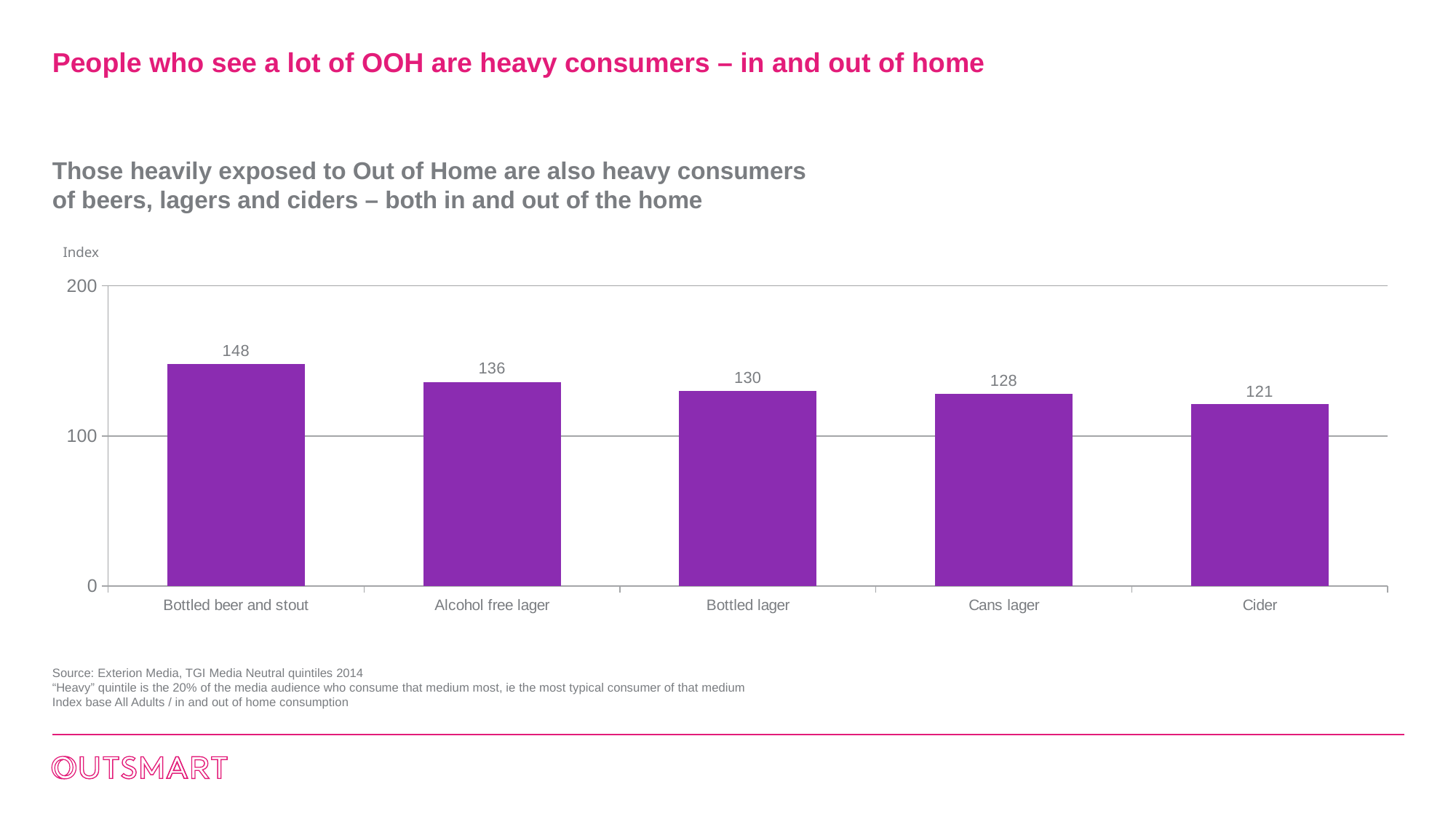
What is the label on the vertical axis of the chart? Index What is the index value for Cans lager? 128 What is the index value for Bottled beer and stout? 148 Which category has the highest index value? Bottled beer and stout Is the index value for Bottled lager greater or less than 100? greater What is the difference between the index values for Bottled beer and stout and Cider? 27 How many categories are shown in the chart? 5 Which has a higher index value, Alcohol free lager or Cans lager? Alcohol free lager Which category has the lowest index value? Cider What is the difference between the index values for Alcohol free lager and Bottled lager? 6 What kind of chart is shown on the slide? Bar chart What is the index value for Cider? 121